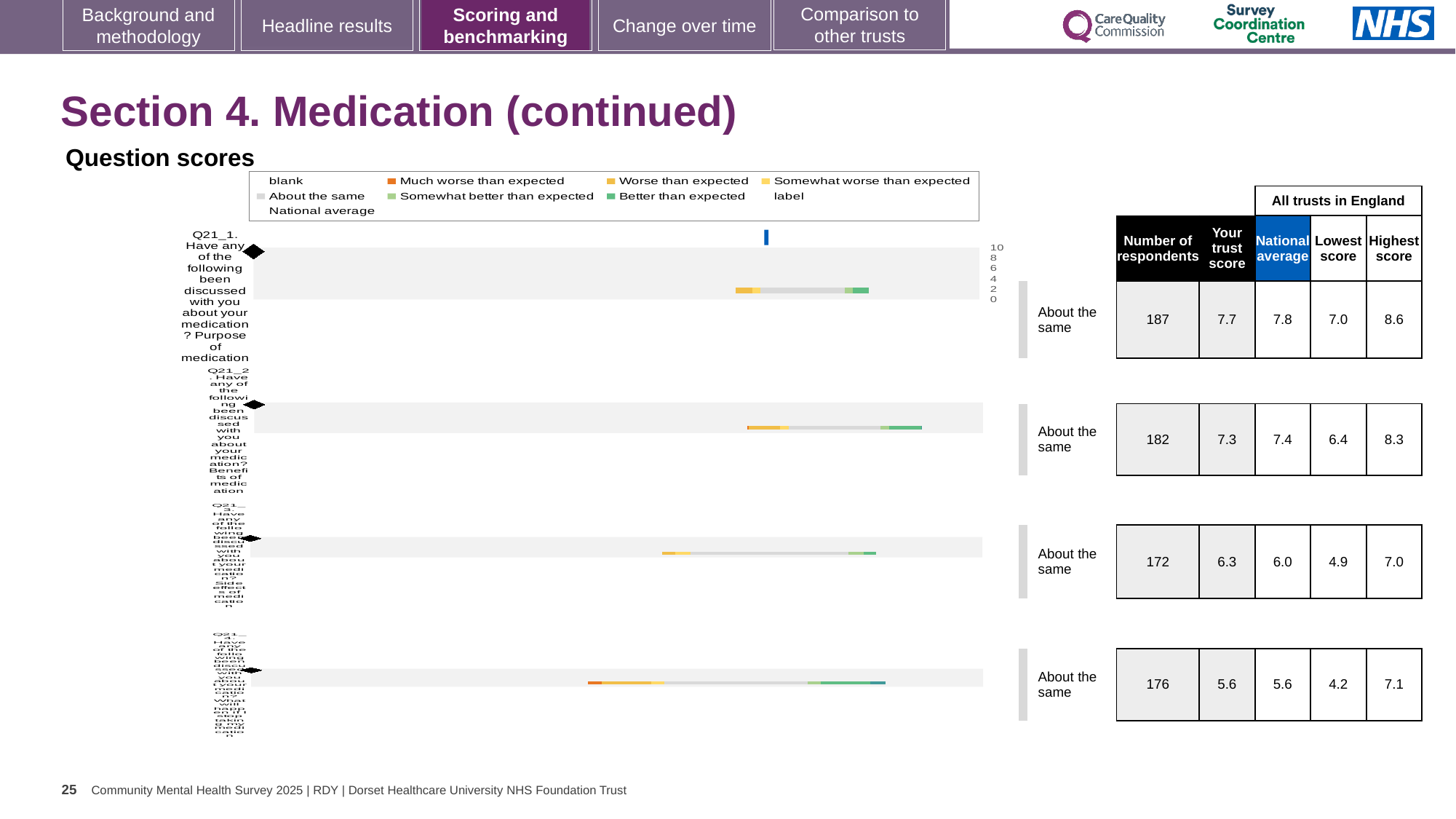
What is the number of respondents for Q21_1 (Purpose of medication)? 187 Which question has the highest number of respondents? Q21_1 How many question bars (Q21_1 to Q21_4) are plotted in the question scores chart? 4 What is the national average for Q21_3? 6.0 In the chart legend, which colour represents 'Much worse than expected'? orange What is the highest score across all trusts in England for Q21_4? 7.1 What is the difference between the highest score (8.6) and the lowest score (7.0) for Q21_1? 1.6 For Q21_3, is the trust score (6.3) higher or lower than the national average (6.0)? higher What is the trust score for Q21_2 (Benefits of medication)? 7.3 What kind of chart is used to show the question scores on this slide? bar chart Which question has the lowest trust score? Q21_4 What benchmark category is shown next to every bar in the question scores chart? About the same